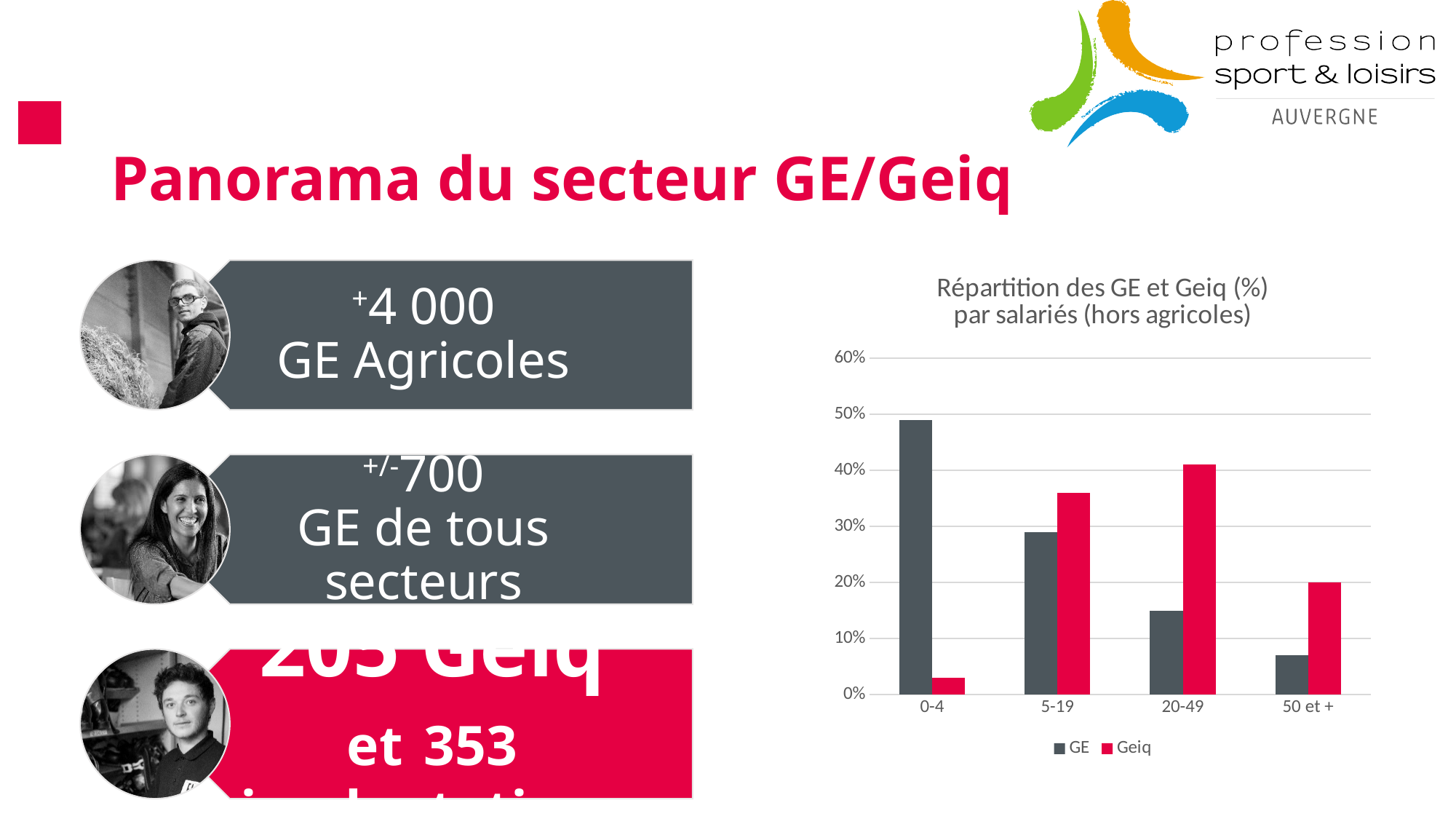
Is the value for GE in the 0-4 category greater or less than 40%? greater How many series does the chart legend list? 2 Which category has the lowest value for the Geiq series? 0-4 Is the value for Geiq in the 0-4 category greater or less than 10%? less Do the GE values rise or fall as you move from 0-4 to 50 et + along the x axis? fall How many categories are shown on the x axis of the chart? 4 What kind of chart is shown on the slide? bar chart Is the value for Geiq in the 20-49 category greater or less than 30%? greater In the 5-19 category, which series has the larger value, GE or Geiq? Geiq Which category has the highest value for the Geiq series? 20-49 Which category has the highest value for the GE series? 0-4 Which category has the lowest value for the GE series? 50 et +